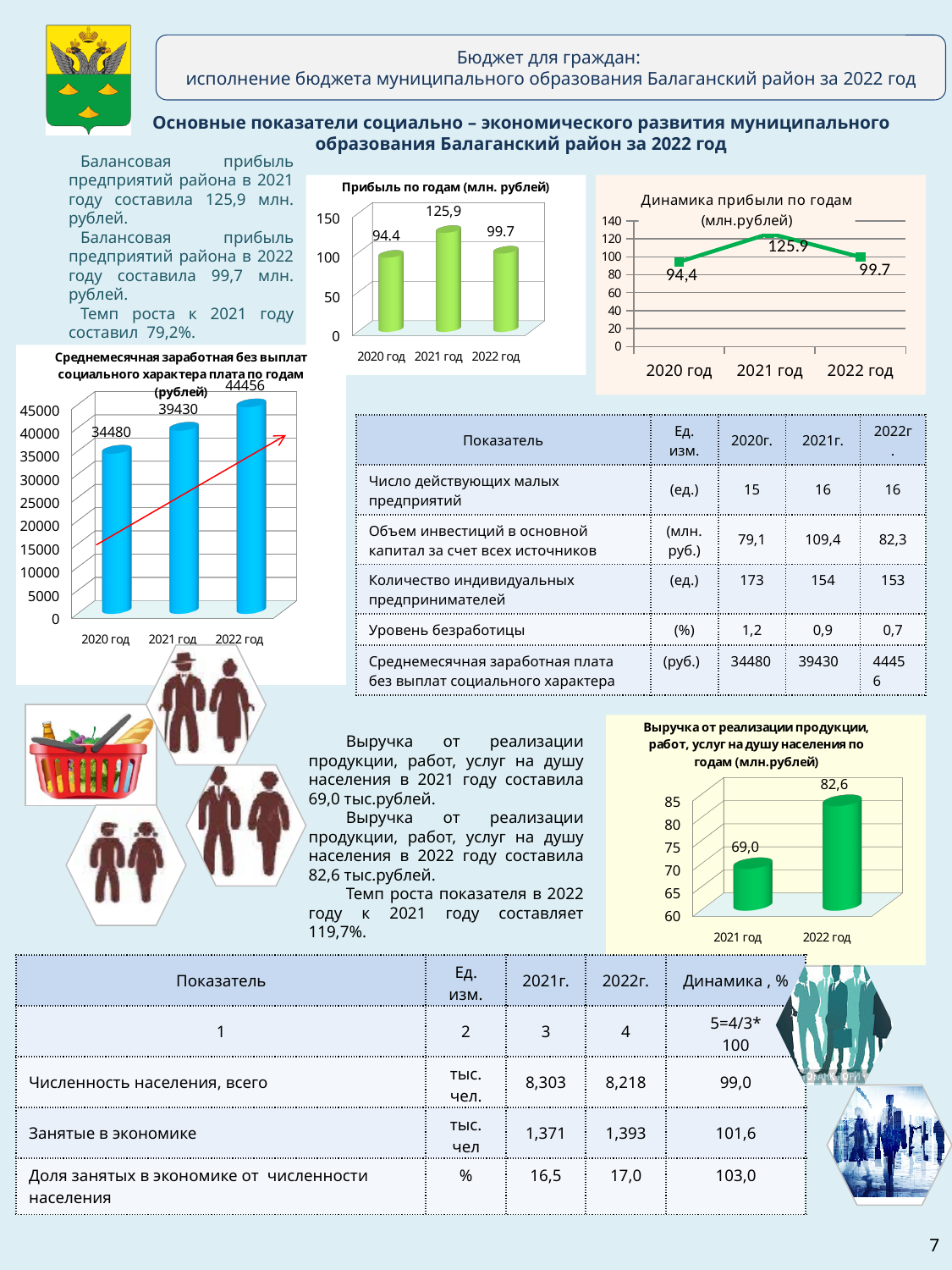
In the chart titled "Прибыль по годам (млн. рублей)", what is the value for 2021 год? 125,9 In the chart titled "Прибыль по годам (млн. рублей)", what is the difference between the 2021 год and 2022 год values? 26.2 In the chart titled "Динамика прибыли по годам (млн.рублей)", how many data points are plotted? 3 In the chart titled "Выручка от реализации продукции, работ, услуг на душу населения по годам (млн.рублей)", what is the value for 2022 год? 82,6 In the chart titled "Среднемесячная заработная без выплат социального характера плата по годам (рублей)", what is the value for 2022 год? 44456 What kind of chart is "Динамика прибыли по годам (млн.рублей)"? line chart In the chart titled "Среднемесячная заработная без выплат социального характера плата по годам (рублей)", do the values rise or fall from 2020 год to 2022 год? rise In the chart titled "Среднемесячная заработная без выплат социального характера плата по годам (рублей)", what is the difference between the 2021 год and 2020 год values? 4950 In the chart titled "Выручка от реализации продукции, работ, услуг на душу населения по годам (млн.рублей)", which year has the larger value, 2021 год or 2022 год? 2022 год In the chart titled "Динамика прибыли по годам (млн.рублей)", what is the value for 2020 год? 94,4 What kind of chart is "Выручка от реализации продукции, работ, услуг на душу населения по годам (млн.рублей)"? bar chart In the chart titled "Прибыль по годам (млн. рублей)", which year has the lowest value? 2020 год